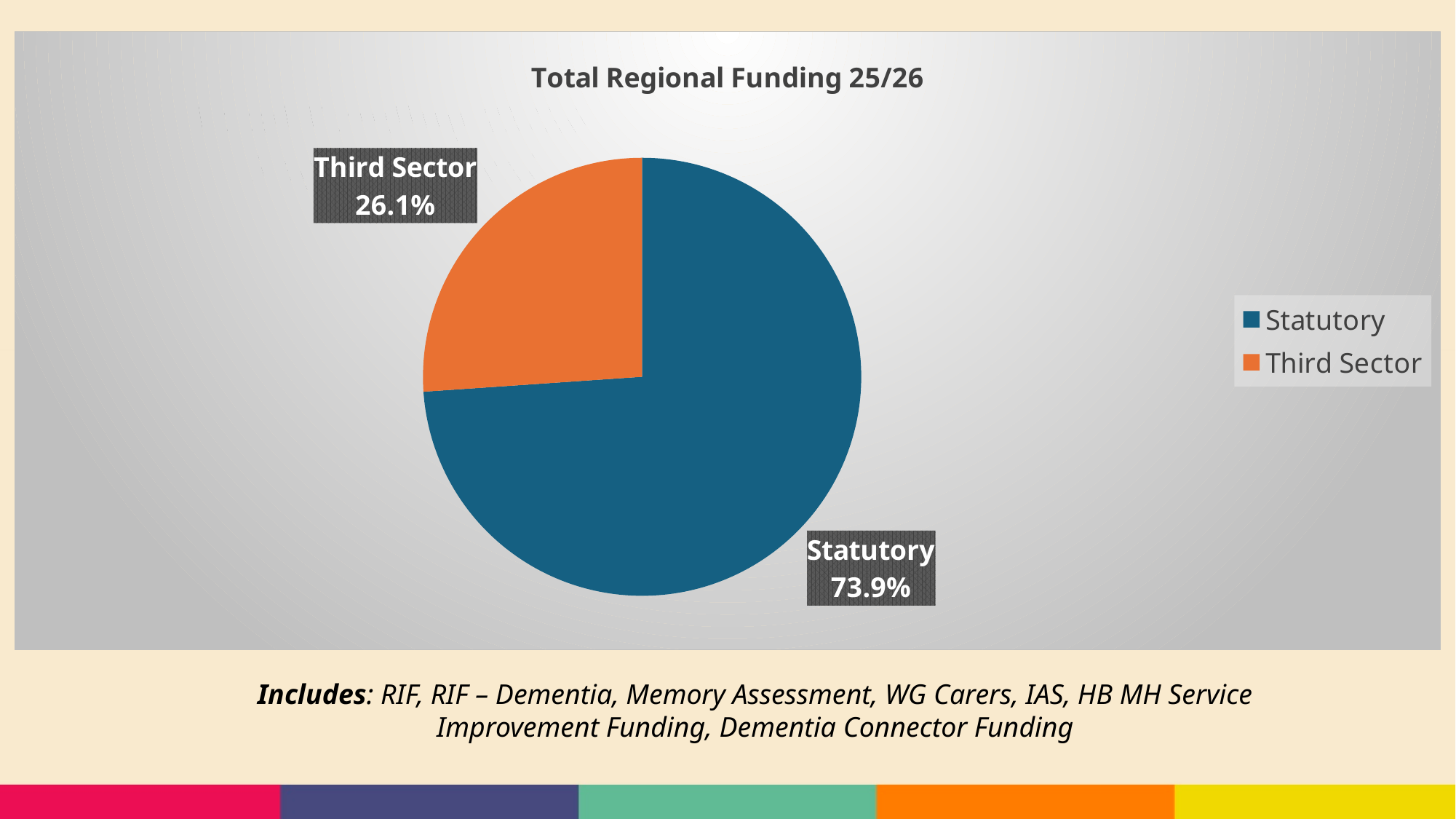
How many slices does the pie chart have? 2 What is the difference in percentage points between Statutory and Third Sector? 47.8 What colour is the Third Sector slice? orange Which is larger, Statutory or Third Sector? Statutory What is the title of the chart? Total Regional Funding 25/26 What share of the pie does Statutory represent? 73.9% What kind of chart is shown on the slide? pie chart Which slice is the largest? Statutory Which slice is the smallest? Third Sector How many entries does the legend list? 2 What share of the pie does Third Sector represent? 26.1%